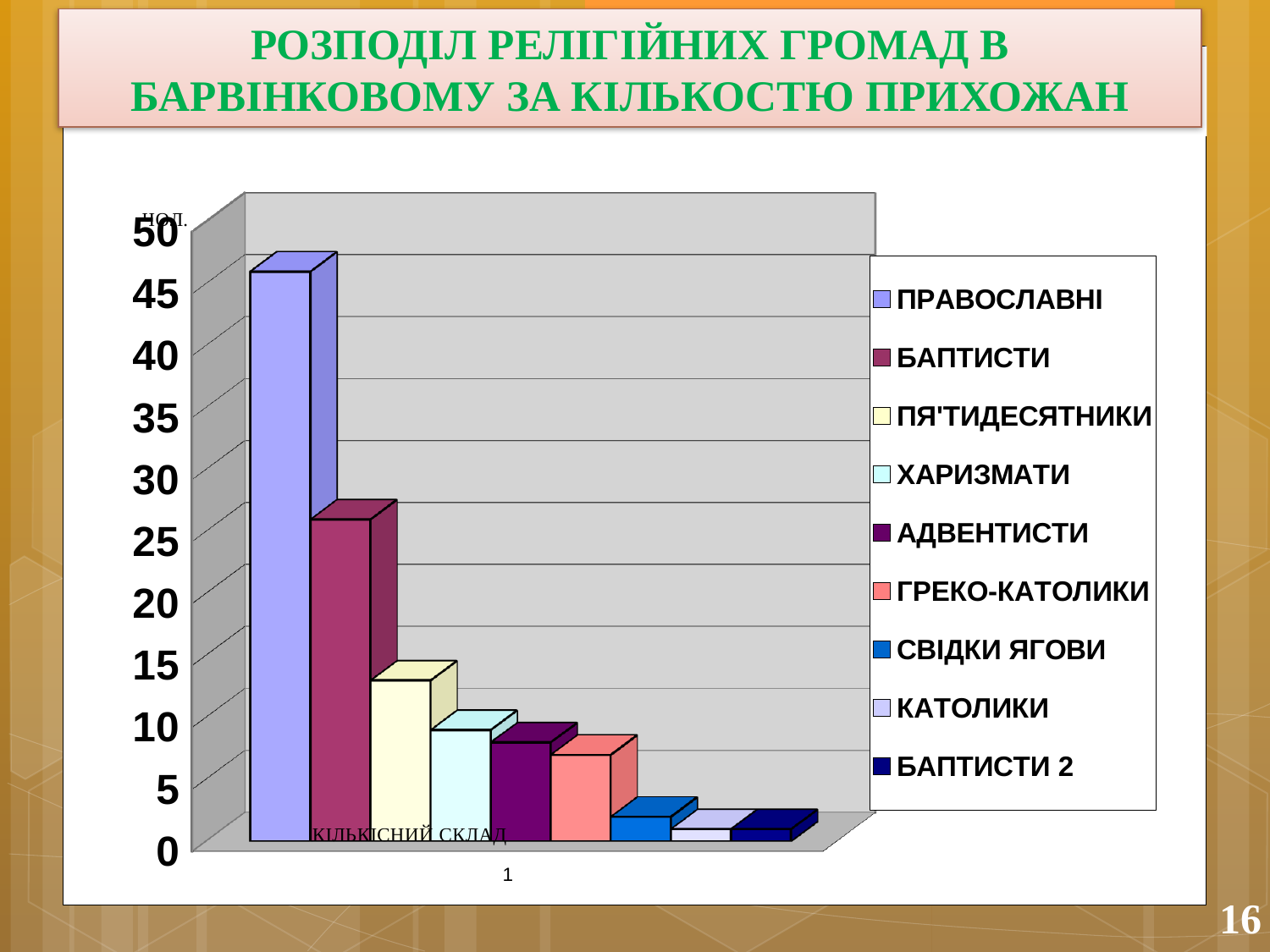
Is the value for ГРЕКО-КАТОЛИКИ greater or less than 10? less Which religious community has the highest number of parishioners? ПРАВОСЛАВНІ Is the value for СВІДКИ ЯГОВИ greater or less than 5? less Which is larger, the value for ПРАВОСЛАВНІ or the value for БАПТИСТИ? ПРАВОСЛАВНІ Is the value for ПРАВОСЛАВНІ greater or less than 40? greater How many series does the legend list? 9 What kind of chart is shown on the slide? bar chart What is the title of the chart on the slide? РОЗПОДІЛ РЕЛІГІЙНИХ ГРОМАД В БАРВІНКОВОМУ ЗА КІЛЬКОСТЮ ПРИХОЖАН Which is larger, the value for ПЯ'ТИДЕСЯТНИКИ or the value for ХАРИЗМАТИ? ПЯ'ТИДЕСЯТНИКИ